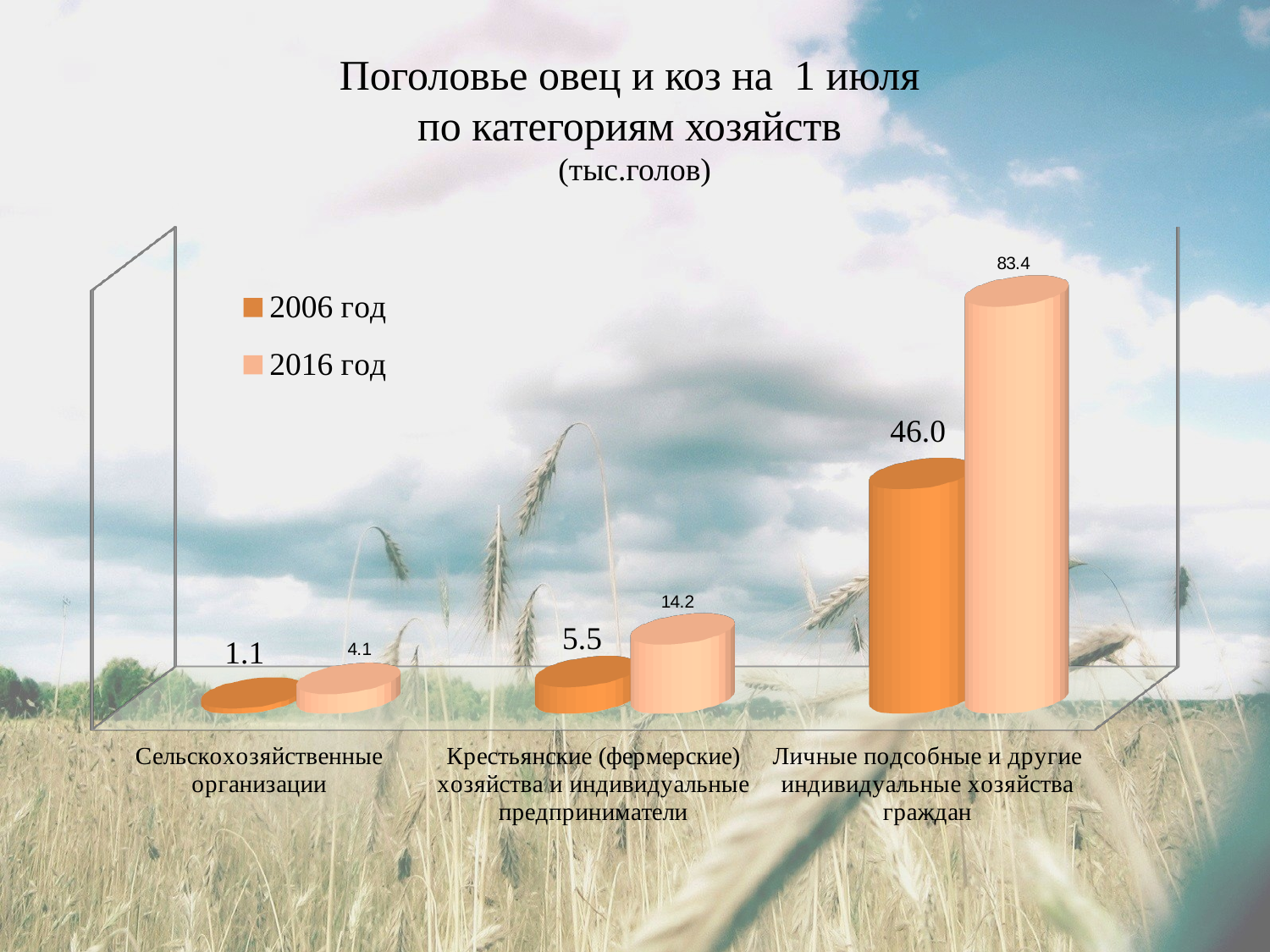
What is the value for Личные подсобные и другие индивидуальные хозяйства граждан in 2006 год? 46.0 Which is larger for Крестьянские (фермерские) хозяйства и индивидуальные предприниматели: the 2006 год value or the 2016 год value? 2016 год Which category has the lowest value in 2006 год? Сельскохозяйственные организации What kind of chart is shown on the slide? Bar chart What is the value for Крестьянские (фермерские) хозяйства и индивидуальные предприниматели in 2016 год? 14.2 What is the difference between the 2016 год and 2006 год values for Крестьянские (фермерские) хозяйства и индивидуальные предприниматели? 8.7 What is the difference between the 2016 год and 2006 год values for Личные подсобные и другие индивидуальные хозяйства граждан? 37.4 How many categories are shown on the x axis? 3 Which category has the highest value in 2016 год? Личные подсобные и другие индивидуальные хозяйства граждан How many series does the legend list? 2 What is the value for Сельскохозяйственные организации in 2006 год? 1.1 What is the value for Сельскохозяйственные организации in 2016 год? 4.1